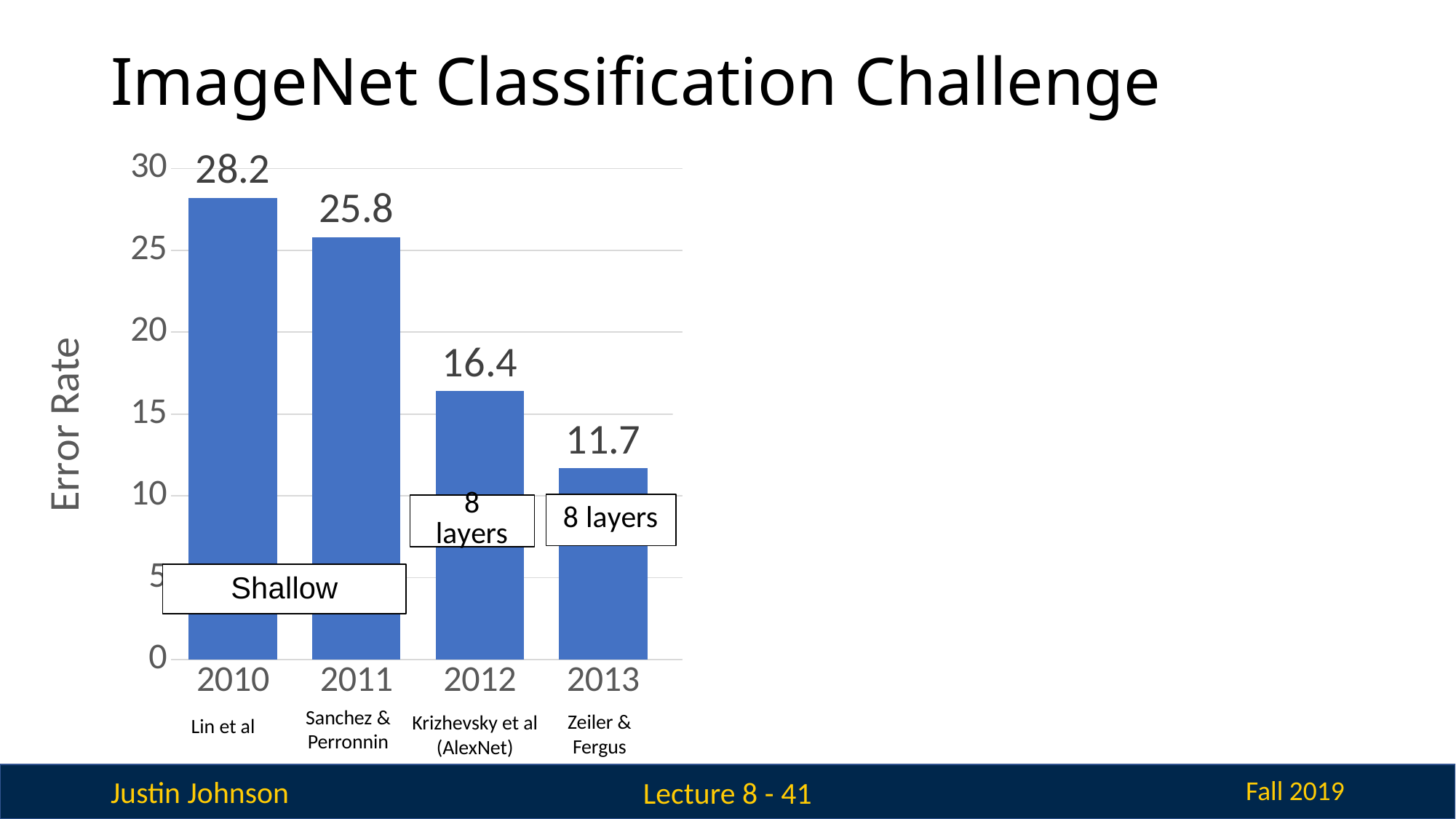
Do the error rates rise or fall from 2010 to 2013? fall What kind of chart is shown on the slide? bar chart Is the error rate for 2012 greater or less than 20? less What is the difference in error rate between 2010 and 2013? 16.5 What is the error rate for 2012? 16.4 Which has a higher error rate, 2011 or 2013? 2011 What is the difference in error rate between 2011 and 2012? 9.4 What is the error rate for 2010? 28.2 Which year has the lowest error rate? 2013 How many years are shown on the chart? 4 What is the error rate for 2013? 11.7 Which year has the highest error rate? 2010